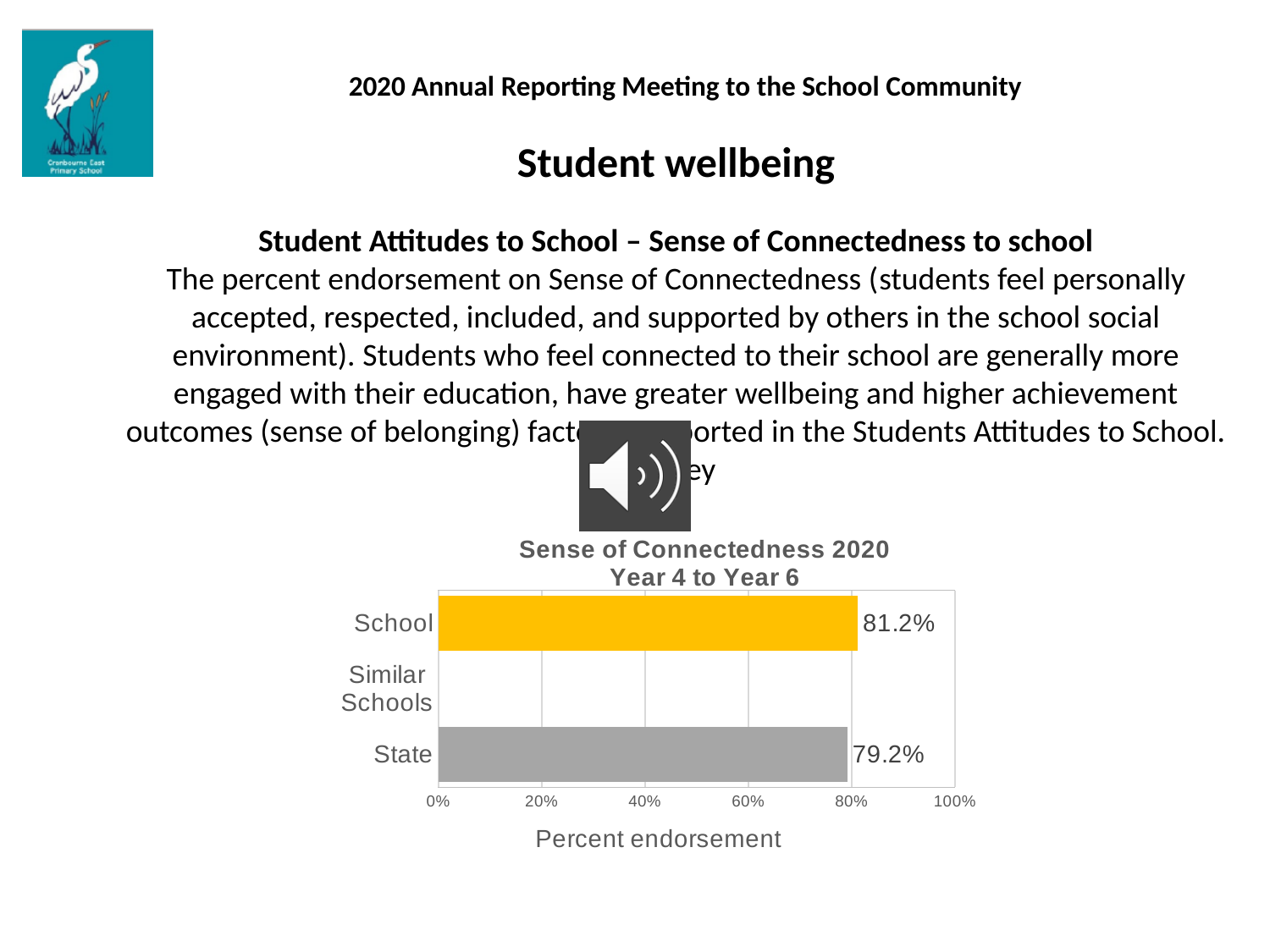
What is the percent endorsement for School in the Sense of Connectedness 2020 chart? 81.2% Which is larger, the School value or the State value? School Which category in the chart has no bar displayed? Similar Schools Is the value for School greater or less than 80%? greater What kind of chart is shown on the slide? Bar chart What is the percent endorsement for State in the Sense of Connectedness 2020 chart? 79.2% How many categories are listed on the vertical axis of the chart? 3 What is the label of the horizontal axis of the chart? Percent endorsement What is the difference between the School and State percent endorsement values? 2.0% Is the value for State greater or less than 80%? less What is the title of the chart? Sense of Connectedness 2020 Year 4 to Year 6 Which category has the highest percent endorsement in the chart? School